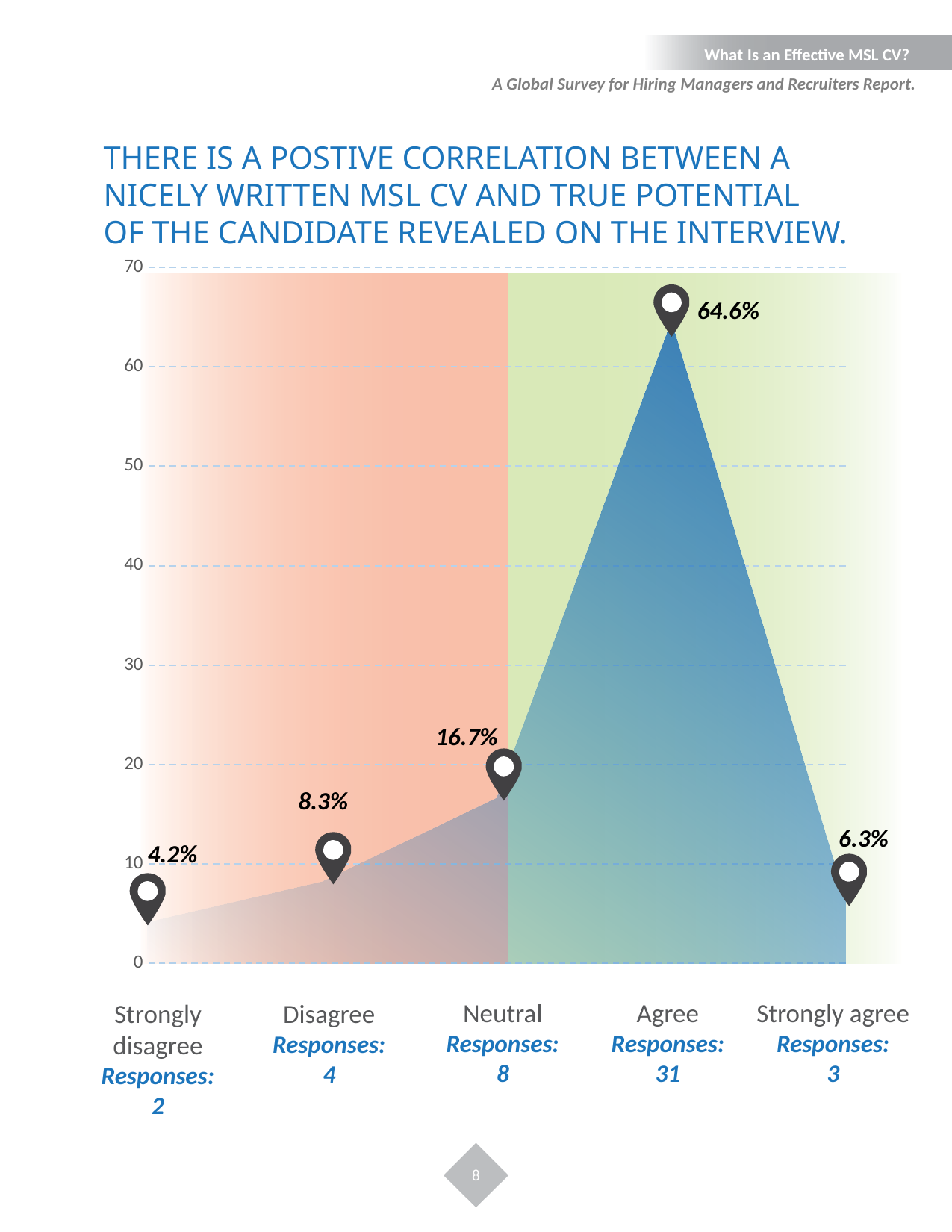
How many responses were recorded for Disagree? 4 Is the value for Agree greater or less than 60? greater What percentage of respondents chose Agree? 64.6% How many categories are shown on the x axis? 5 Which has a larger percentage, Disagree or Strongly agree? Disagree What is the total number of responses across all five categories? 48 Do the values rise or fall from Strongly disagree to Agree? rise Which category has the highest percentage? Agree What percentage of respondents chose Neutral? 16.7% Which category has the lowest percentage? Strongly disagree What percentage of respondents chose Strongly disagree? 4.2% What is the difference in percentage points between Agree and Neutral? 47.9